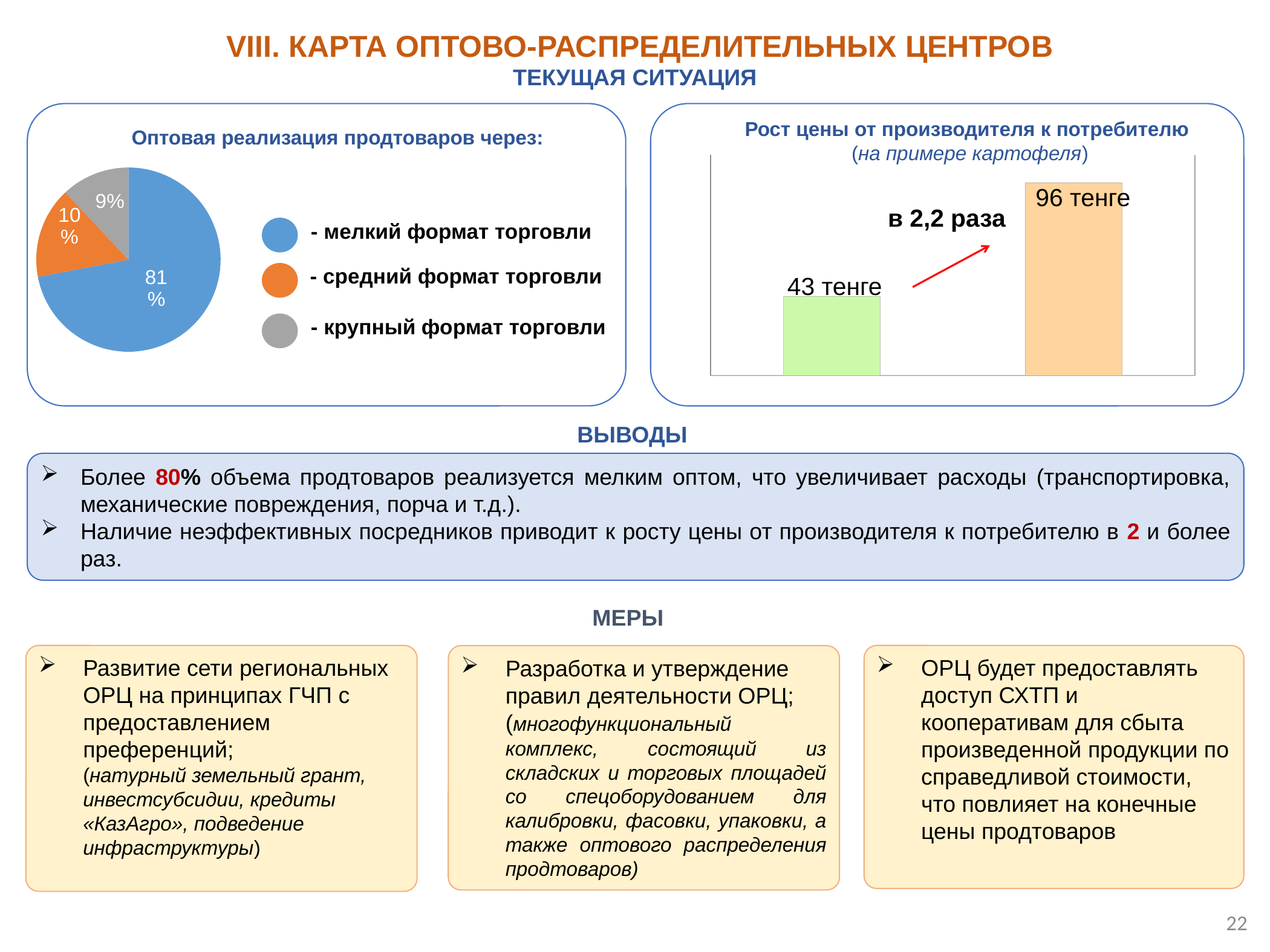
In the pie chart 'Оптовая реализация продтоваров через:', what share is attributed to мелкий формат торговли? 81% In the pie chart 'Оптовая реализация продтоваров через:', what share is attributed to крупный формат торговли? 9% In the pie chart 'Оптовая реализация продтоваров через:', which trade format has the largest share? мелкий формат торговли In the pie chart 'Оптовая реализация продтоваров через:', how many slices does the pie have? 3 In the chart 'Рост цены от производителя к потребителю', by what factor does the annotation say the price grows? в 2,2 раза In the pie chart 'Оптовая реализация продтоваров через:', which trade format has the smallest share? крупный формат торговли In the pie chart 'Оптовая реализация продтоваров через:', what share is attributed to средний формат торговли? 10% In the pie chart 'Оптовая реализация продтоваров через:', what colour is the slice for средний формат торговли? Orange In the chart 'Рост цены от производителя к потребителю', what is the value of the left (green) bar? 43 тенге In the chart 'Рост цены от производителя к потребителю', what is the value of the right (orange) bar? 96 тенге In the chart 'Рост цены от производителя к потребителю', what is the difference between the right bar and the left bar? 53 тенге What kind of chart is 'Рост цены от производителя к потребителю (на примере картофеля)'? Bar chart